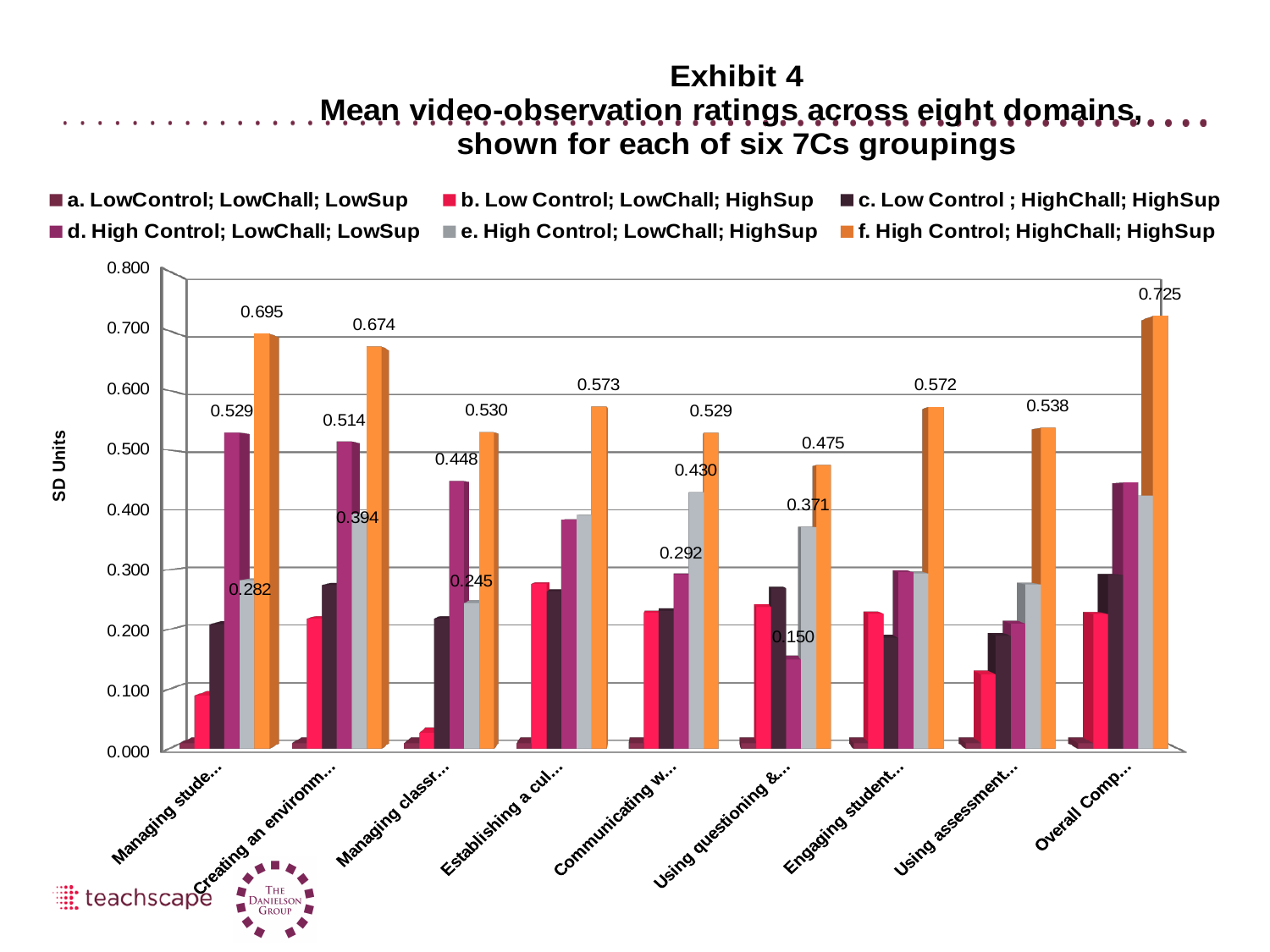
What kind of chart is shown on the slide? bar chart In which category does the 'f. High Control; HighChall; HighSup' series reach its highest value? Overall Comp... What is the title of the vertical axis? SD Units What is the value for the 'd. High Control; LowChall; LowSup' series in the 'Using questioning &...' category? 0.150 What is the difference between the 'f. High Control; HighChall; HighSup' values for 'Managing stude...' and 'Creating an environm...'? 0.021 For the 'f. High Control; HighChall; HighSup' series, which is larger: the value for 'Managing stude...' or for 'Creating an environm...'? Managing stude... How many categories are shown along the x axis? 9 Is the value for the 'b. Low Control; LowChall; HighSup' series in the 'Managing classr...' category greater or less than 0.100? less What is the value for the 'e. High Control; LowChall; HighSup' series in the 'Communicating w...' category? 0.430 What is the value for the 'f. High Control; HighChall; HighSup' series in the 'Overall Comp...' category? 0.725 In which category does the 'f. High Control; HighChall; HighSup' series have its lowest value? Using questioning &... How many series does the legend list? 6